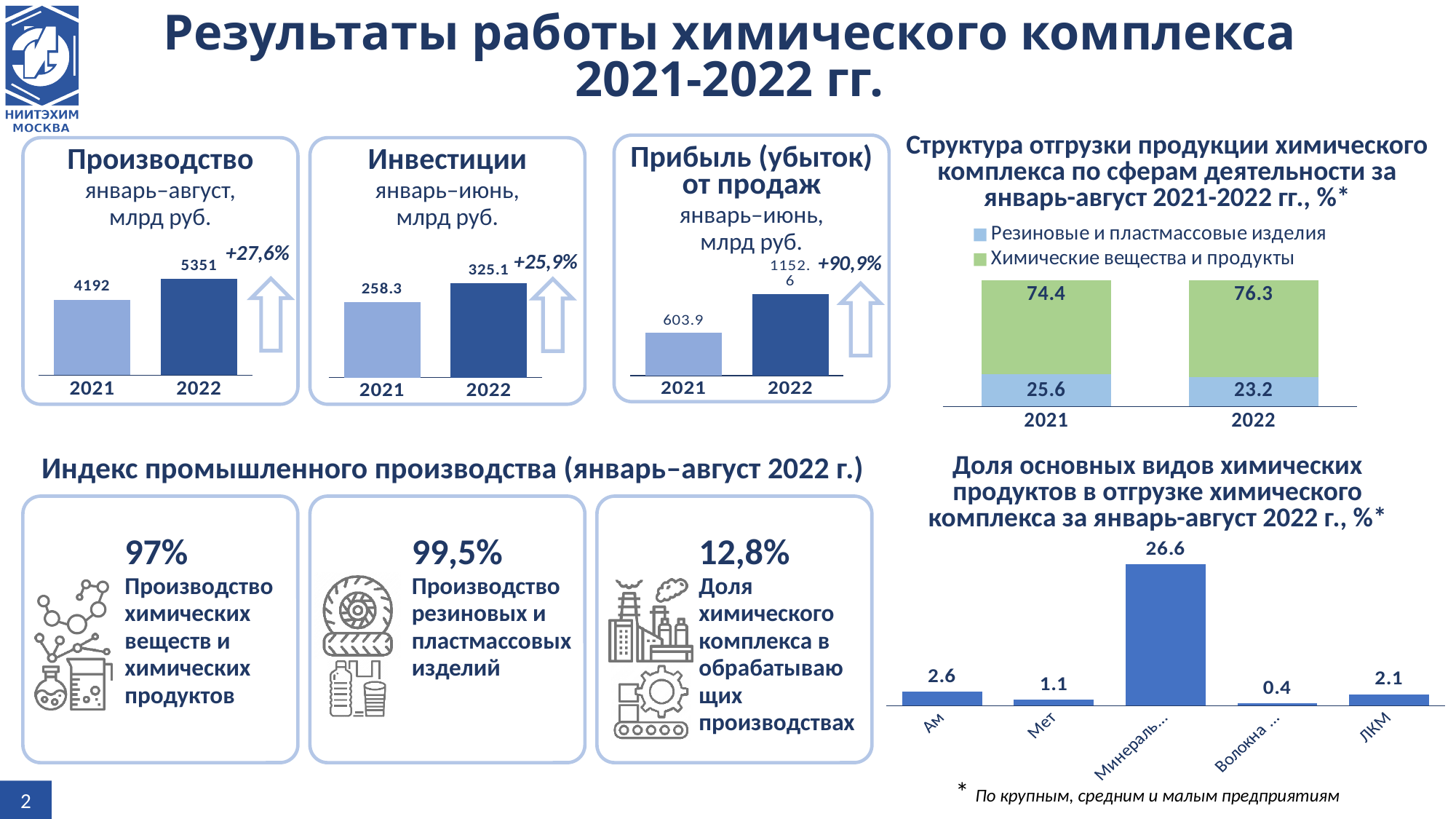
In the 'Структура отгрузки продукции химического комплекса' chart, what is the value for 'Химические вещества и продукты' in 2021? 74.4 In the 'Инвестиции' chart, what is the value for 2021? 258.3 In the 'Доля основных видов химических продуктов' chart, which category has the lowest value? Волокна … How many categories are shown in the 'Доля основных видов химических продуктов' chart? 5 In the 'Инвестиции' chart, which year has the higher value, 2021 or 2022? 2022 In the 'Производство' chart, what is the value for 2022? 5351 In the 'Прибыль (убыток) от продаж' chart, what percentage change is shown next to the arrow? +90,9% In the 'Структура отгрузки продукции химического комплекса' chart, what is the value for 'Резиновые и пластмассовые изделия' in 2022? 23.2 How many series does the legend of the 'Структура отгрузки продукции химического комплекса' chart list? 2 In the 'Производство' chart, what is the difference between the 2022 and 2021 values? 1159 In the 'Доля основных видов химических продуктов' chart, what is the value for 'ЛКМ'? 2.1 In the 'Прибыль (убыток) от продаж' chart, what is the value for 2021? 603.9